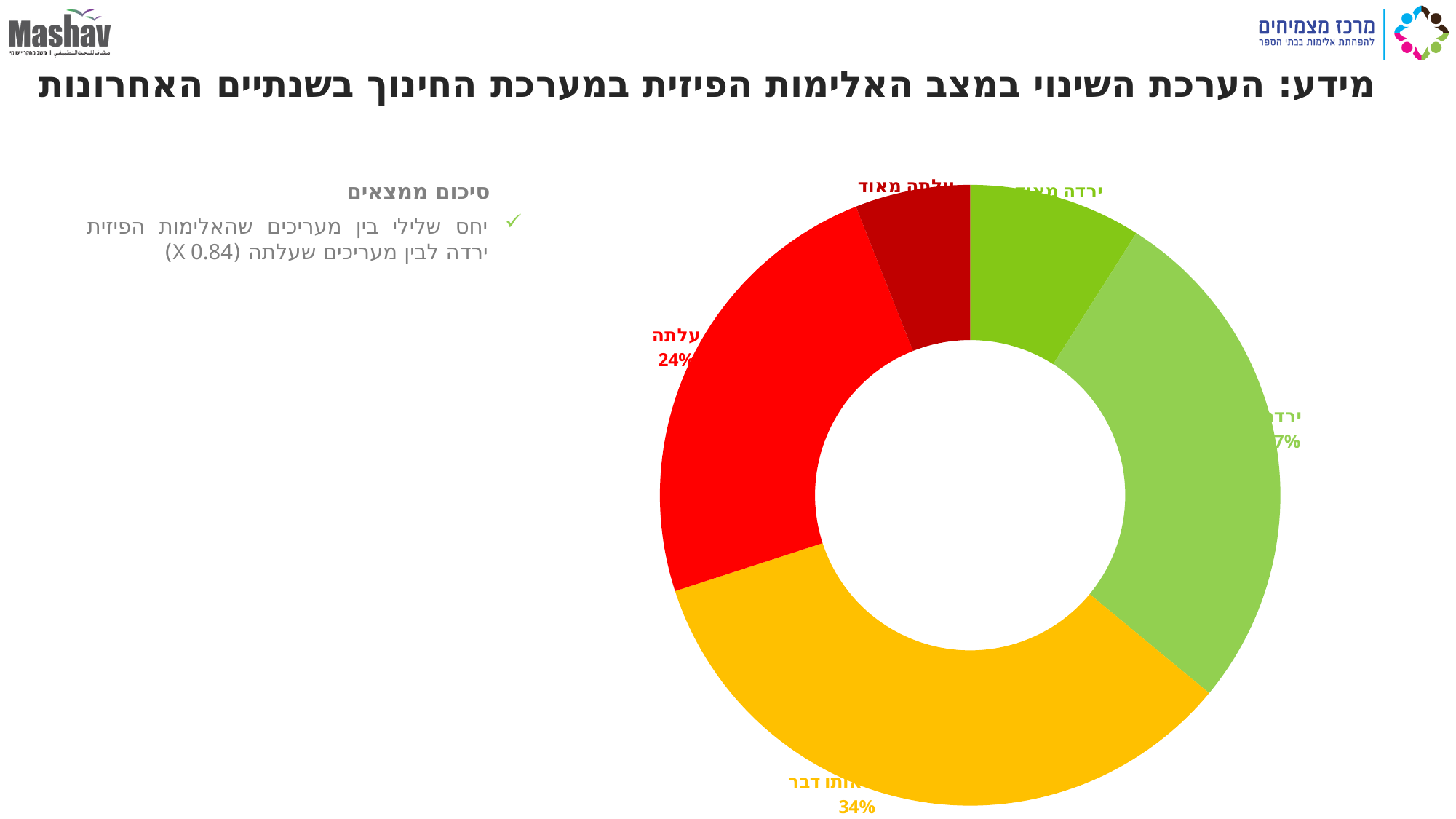
What is the difference in percentage points between the "אותו דבר" slice and the "עלתה" slice? 10 percentage points What kind of chart is shown on the slide? Donut (pie) chart Is the "עלתה" slice larger or smaller than the "אותו דבר" slice? smaller What percentage is shown for the "עלתה" slice? 24% How many slices does the donut chart have? 5 What colour is the "עלתה" slice? Red Which category has the largest slice in the donut chart? אותו דבר What percentage is shown for the "אותו דבר" slice? 34% What colour is the "אותו דבר" slice? Yellow What share of the whole does the "אותו דבר" slice represent? 34% Which slice is larger, "עלתה" or "אותו דבר"? אותו דבר